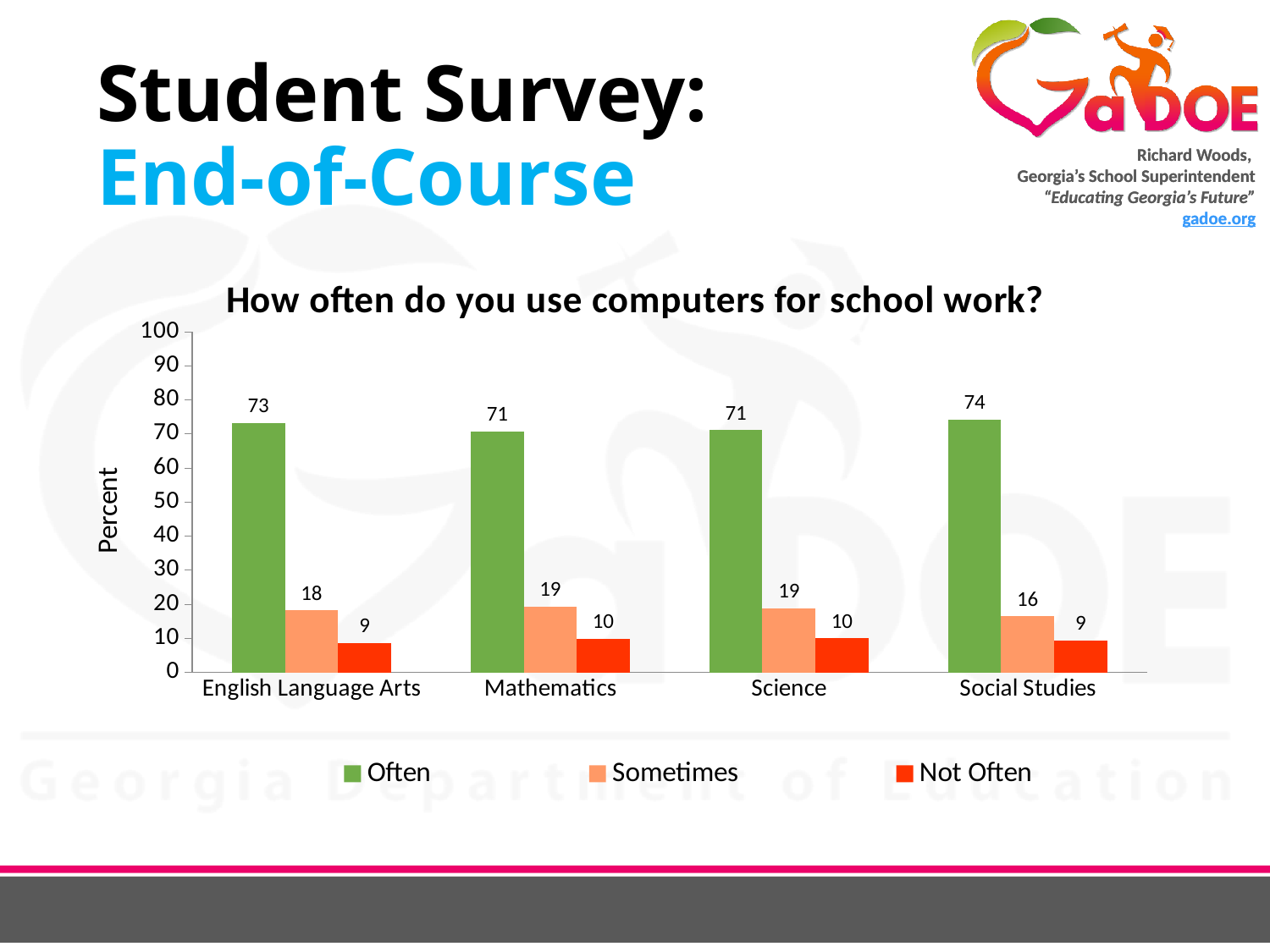
What is the title of the chart? How often do you use computers for school work? Which subject has the lowest value for Sometimes? Social Studies How many subjects are shown on the x axis? 4 How many series does the legend list? 3 What is the value for Often in English Language Arts? 73 What is the value for Sometimes in Mathematics? 19 What is the value for Not Often in Social Studies? 9 What is the label on the y axis? Percent Which is larger, the Not Often value for Science or for English Language Arts? Science Which subject has the highest value for Often? Social Studies What is the difference between the Often values for Social Studies and Mathematics? 3 What kind of chart is shown? bar chart